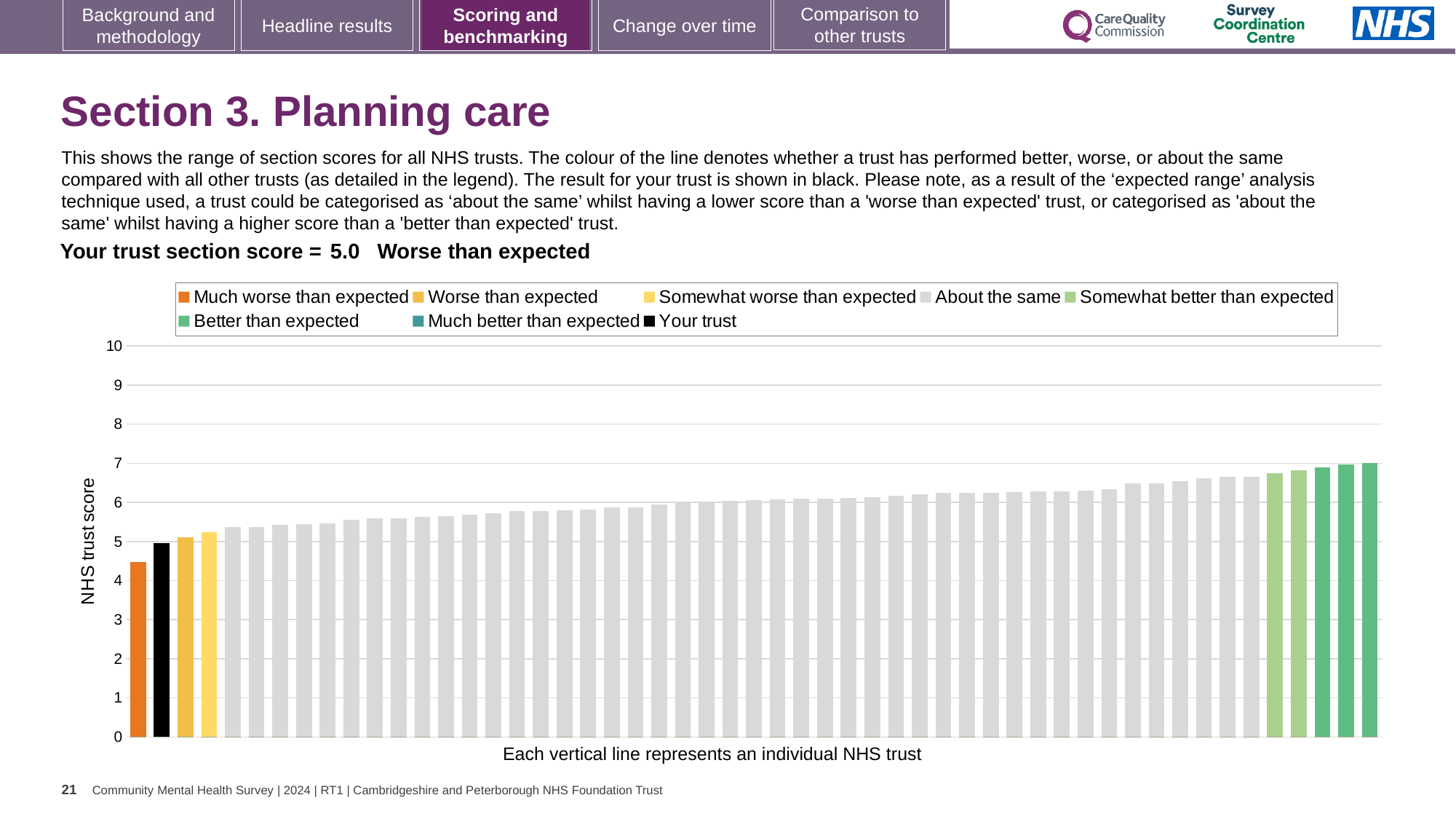
Is the value for your trust greater or less than 6? less Is the value of the tallest bar in the chart greater or less than 8? less What colour is used for the bar representing your trust? black What is the label on the vertical axis of the chart? NHS trust score Is the value of the tallest bar in the chart greater or less than 6? greater Do the bar values rise or fall from left to right along the x axis? rise How many entries does the chart legend list? 8 What kind of chart is shown on the slide? bar chart Which is larger: the score for your trust (black bar) or the score of the orange 'Much worse than expected' bar? your trust Which performance category is your trust placed in for Section 3. Planning care? Worse than expected What is the section score for your trust shown on the slide? 5.0